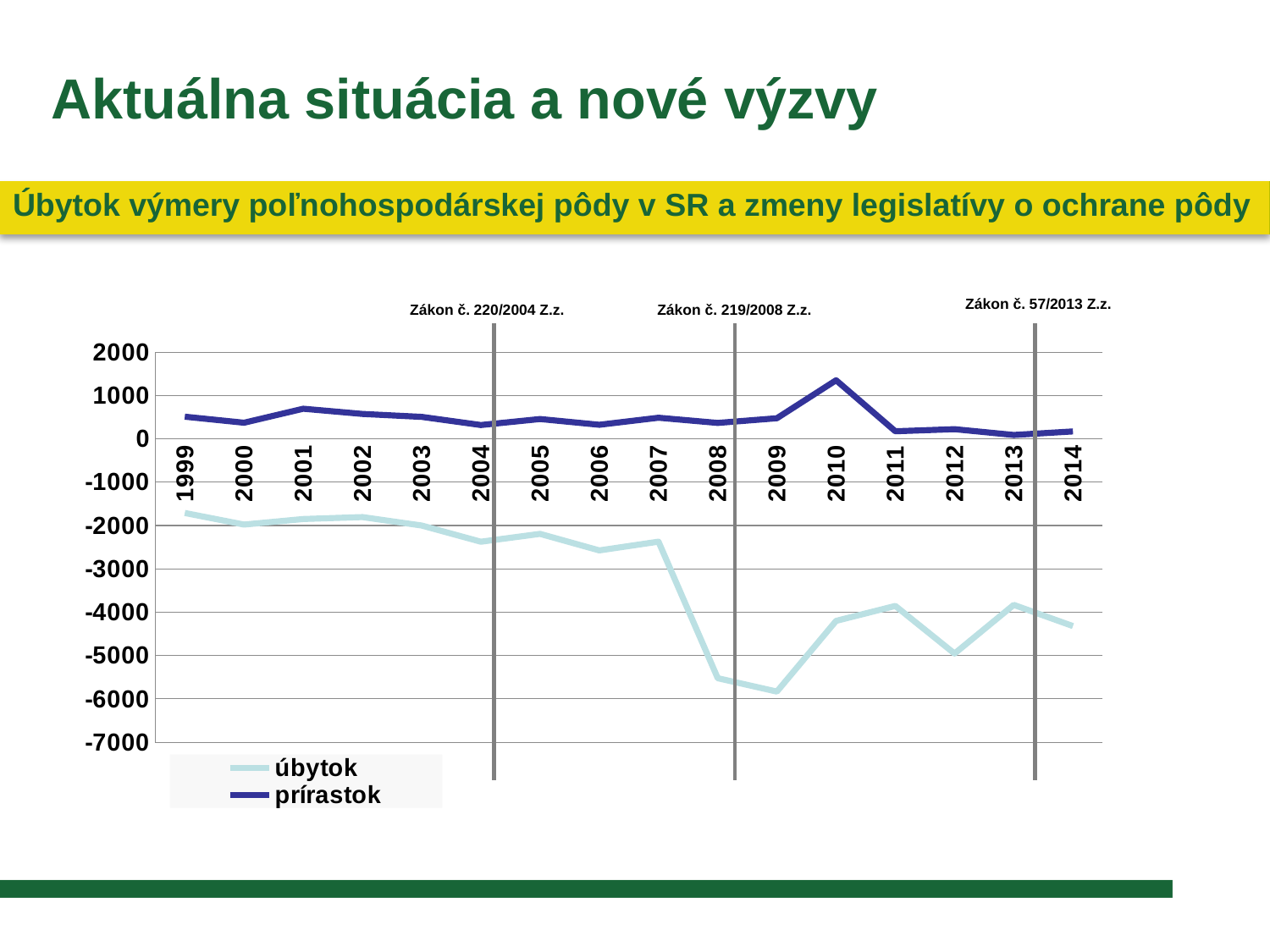
How many years are plotted along the x axis? 16 Is the úbytok value for 1999 greater or less than -2000? greater Is the prírastok value for 2010 greater or less than 1000? greater Is the úbytok value for 2009 greater or less than -5000? less Which year has the higher úbytok value, 2007 or 2008? 2007 Does the úbytok series rise or fall between 2007 and 2009? fall What are the two series named in the legend? úbytok and prírastok In which year does the úbytok series reach its lowest value? 2009 What kind of chart is shown on the slide? line chart How many series does the legend list? 2 In which year does the prírastok series reach its highest value? 2010 Which law is labelled at the vertical line at 2008? Zákon č. 219/2008 Z.z.